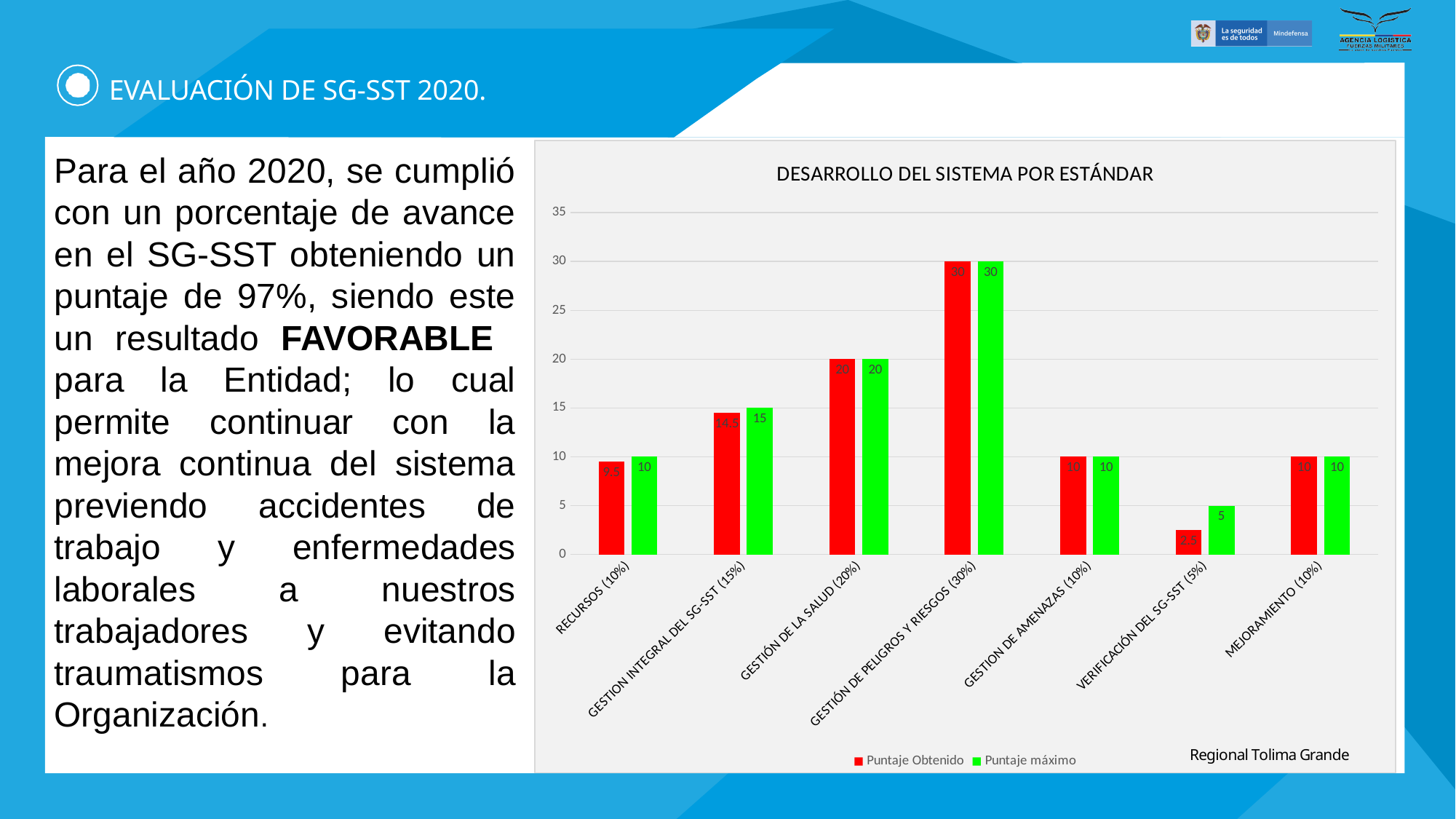
Which category has the lowest Puntaje máximo? VERIFICACIÓN DEL SG-SST (5%) How many series does the legend list? 2 What type of chart is shown? Bar chart What is the Puntaje máximo value for GESTION INTEGRAL DEL SG-SST (15%)? 15 Which category has the highest Puntaje Obtenido? GESTIÓN DE PELIGROS Y RIESGOS (30%) How many categories are shown on the x axis? 7 What is the difference between Puntaje máximo and Puntaje Obtenido for VERIFICACIÓN DEL SG-SST (5%)? 2.5 Is the Puntaje Obtenido for GESTIÓN DE PELIGROS Y RIESGOS (30%) greater or less than 25? greater Which is larger for GESTIÓN DE LA SALUD (20%): Puntaje Obtenido or Puntaje máximo? They are equal (20) What is the difference between Puntaje máximo and Puntaje Obtenido for GESTION INTEGRAL DEL SG-SST (15%)? 0.5 What is the Puntaje Obtenido value for VERIFICACIÓN DEL SG-SST (5%)? 2.5 What is the Puntaje Obtenido value for RECURSOS (10%)? 9.5